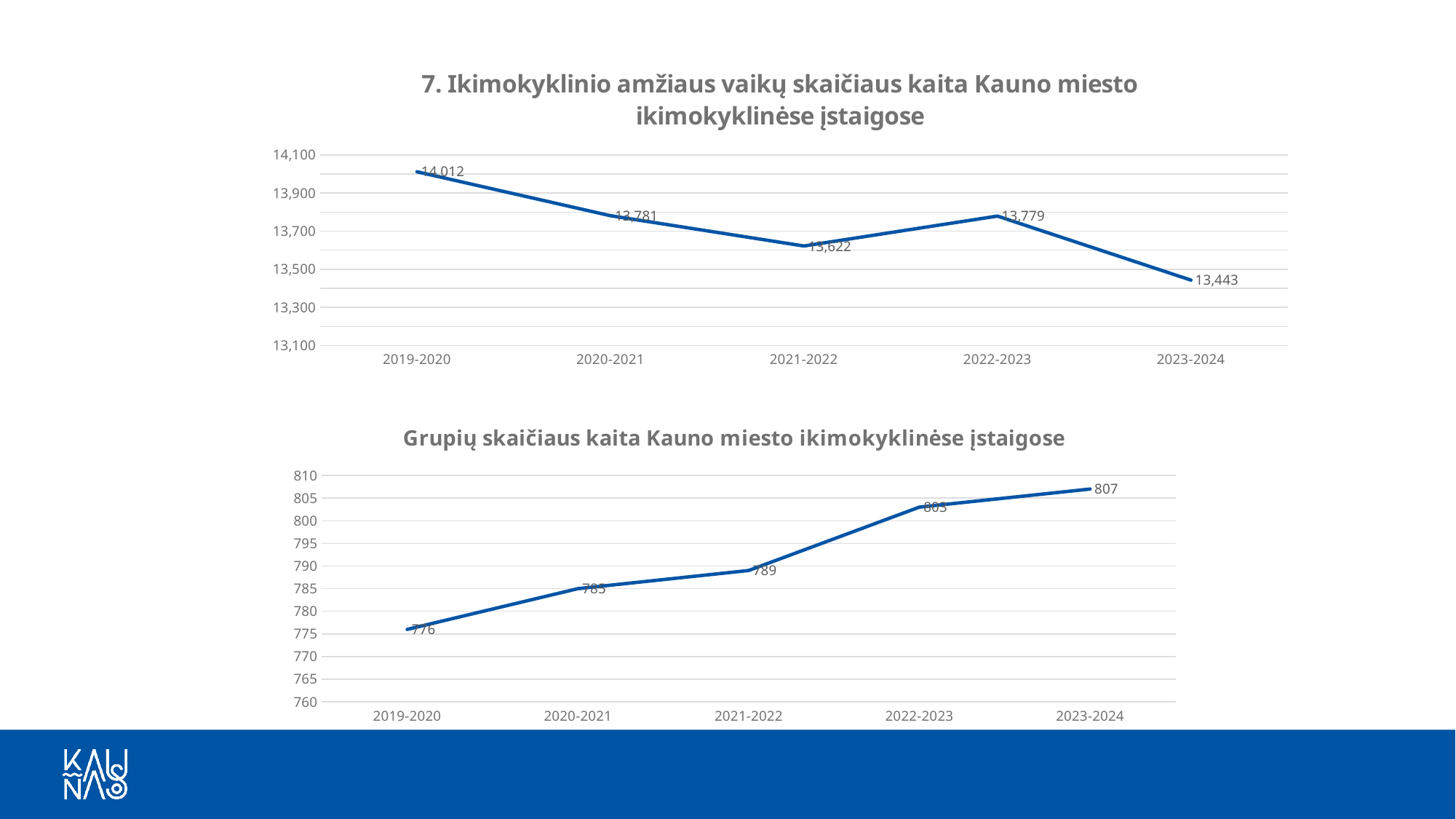
In the bottom chart (Grupių skaičiaus kaita), which is larger, the value for 2020-2021 or the value for 2022-2023? 2022-2023 In the top chart (Ikimokyklinio amžiaus vaikų skaičiaus kaita), what is the value for 2019-2020? 14,012 In the bottom chart (Grupių skaičiaus kaita), do the values rise or fall from 2019-2020 to 2023-2024? rise In the bottom chart (Grupių skaičiaus kaita), what is the difference between the 2023-2024 value and the 2019-2020 value? 31 In the top chart (Ikimokyklinio amžiaus vaikų skaičiaus kaita), how many periods are plotted? 5 In the top chart (Ikimokyklinio amžiaus vaikų skaičiaus kaita), what is the difference between the 2019-2020 value and the 2021-2022 value? 390 In the bottom chart (Grupių skaičiaus kaita), what is the value for 2023-2024? 807 What type of chart is the bottom chart (Grupių skaičiaus kaita)? line chart In the top chart (Ikimokyklinio amžiaus vaikų skaičiaus kaita), which period has the highest value? 2019-2020 In the top chart (Ikimokyklinio amžiaus vaikų skaičiaus kaita), which period has the lowest value? 2023-2024 In the bottom chart (Grupių skaičiaus kaita), what is the value for 2021-2022? 789 In the top chart (Ikimokyklinio amžiaus vaikų skaičiaus kaita), what is the value for 2023-2024? 13,443